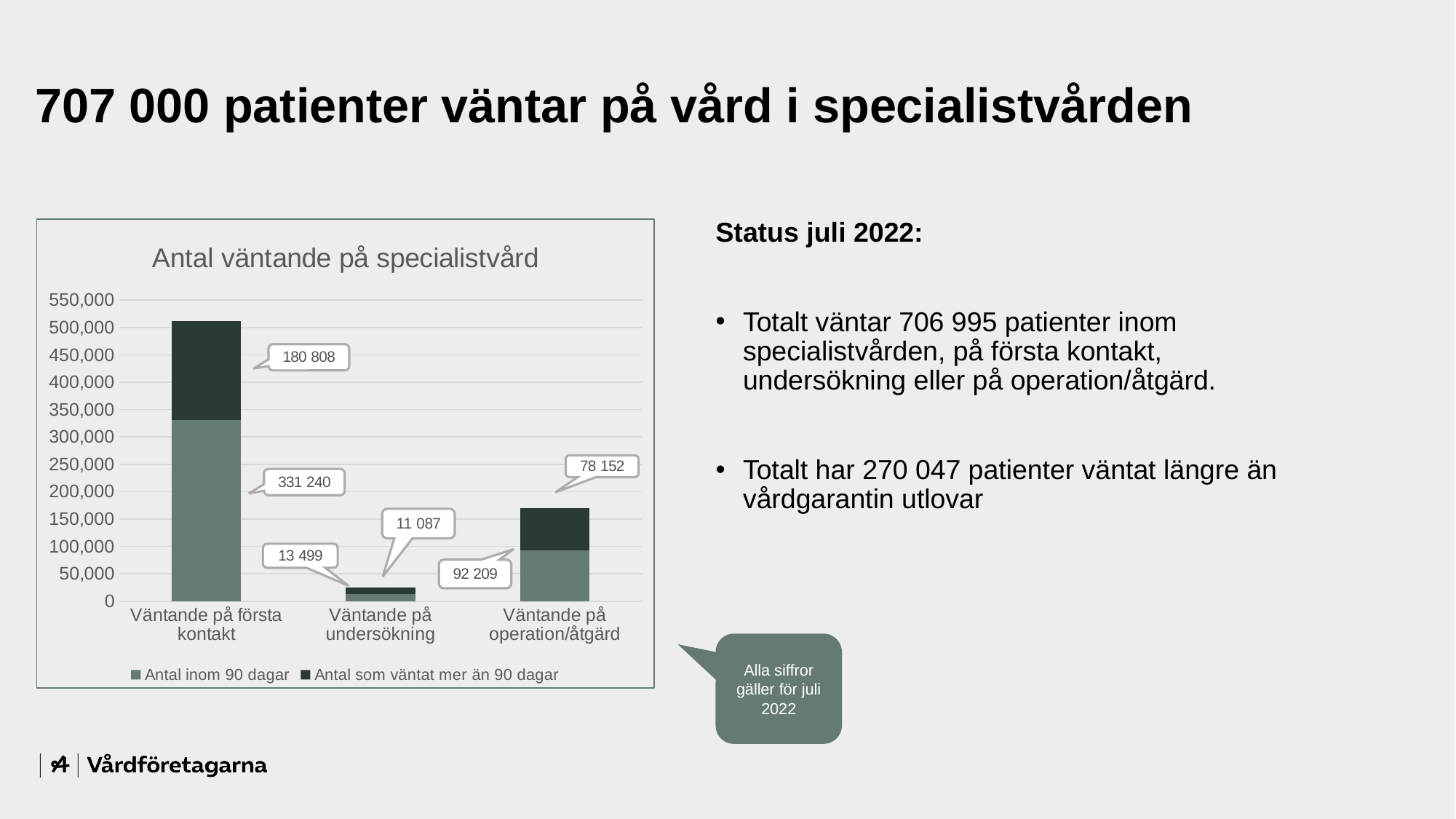
Which category has the lowest total number of waiting patients? Väntande på undersökning What is the difference between 'Antal inom 90 dagar' and 'Antal som väntat mer än 90 dagar' for 'Väntande på första kontakt'? 150 432 What type of chart is shown on the slide? Stacked bar chart Which category has the highest total number of waiting patients? Väntande på första kontakt What is the title of the chart? Antal väntande på specialistvård What is the value of 'Antal inom 90 dagar' for 'Väntande på första kontakt'? 331 240 What is the value of 'Antal som väntat mer än 90 dagar' for 'Väntande på operation/åtgärd'? 78 152 What is the value of 'Antal inom 90 dagar' for 'Väntande på undersökning'? 13 499 What is the total of the stacked bar for 'Väntande på operation/åtgärd'? 170 361 How many series does the legend list? 2 How many categories are shown on the x axis? 3 Is the total for 'Väntande på första kontakt' greater or less than 500,000? greater